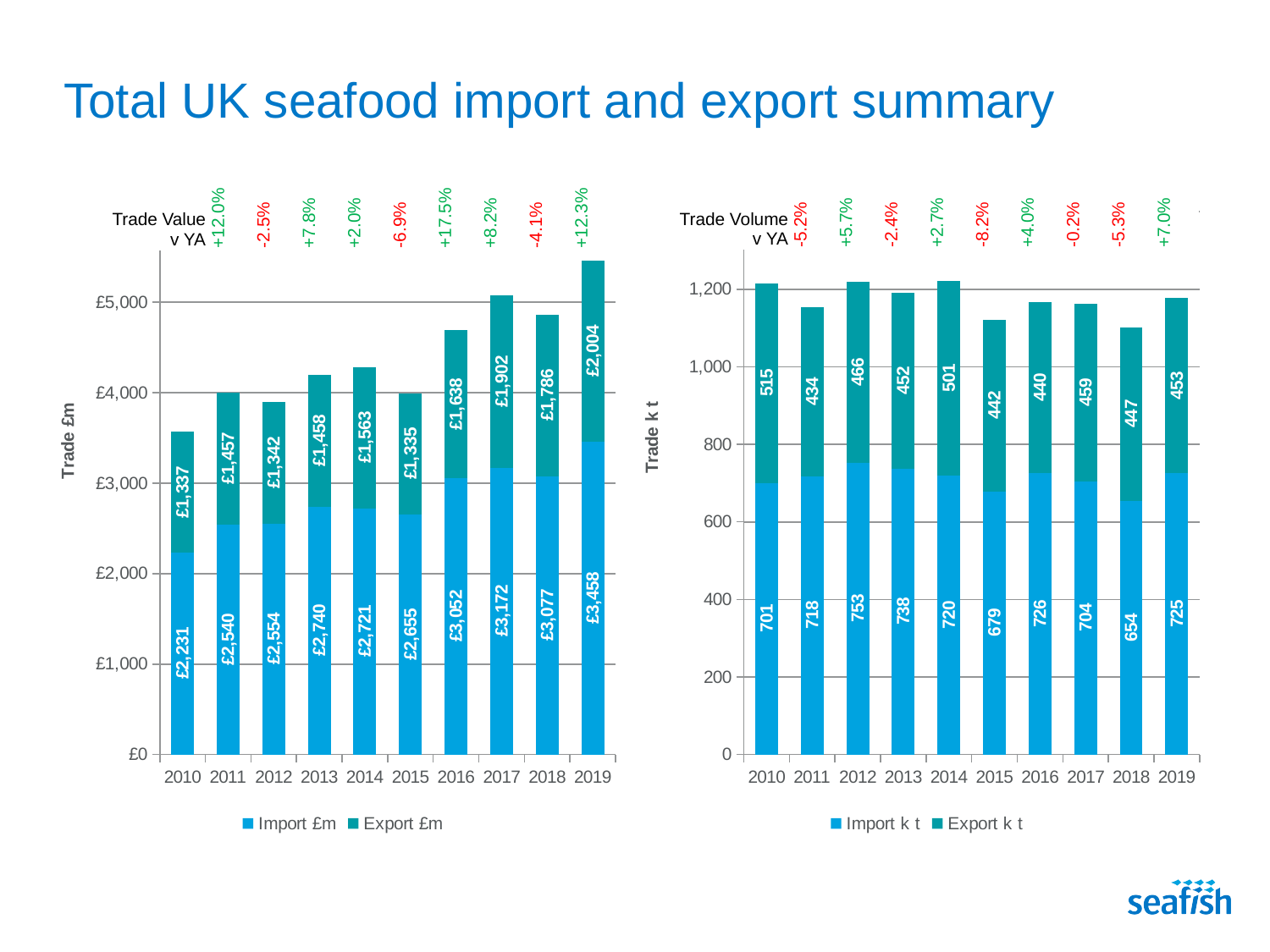
On the right chart (Trade Volume), what is the Export k t value for 2010? 515 How many series does the legend of the right chart (Trade Volume) list? 2 How many years are shown on the x axis of the left chart (Trade Value)? 10 On the left chart (Trade Value), what is the Export £m value for 2014? £1,563 On the right chart (Trade Volume), what is the total of the stacked bar for 2019? 1,178 On the left chart (Trade Value), what is the difference between Import £m and Export £m in 2019? £1,454 On the left chart (Trade Value), which year has the highest Export £m value? 2019 On the right chart (Trade Volume), which year has the lowest Import k t value? 2018 On the left chart (Trade Value), what is the Import £m value for 2019? £3,458 On the left chart (Trade Value), is the Import £m value for 2016 larger than the Import £m value for 2015? Yes, 2016 (£3,052) is larger On the right chart (Trade Volume), which year has the highest Import k t value? 2012 What kind of chart is the left chart (Trade Value)? Stacked bar chart